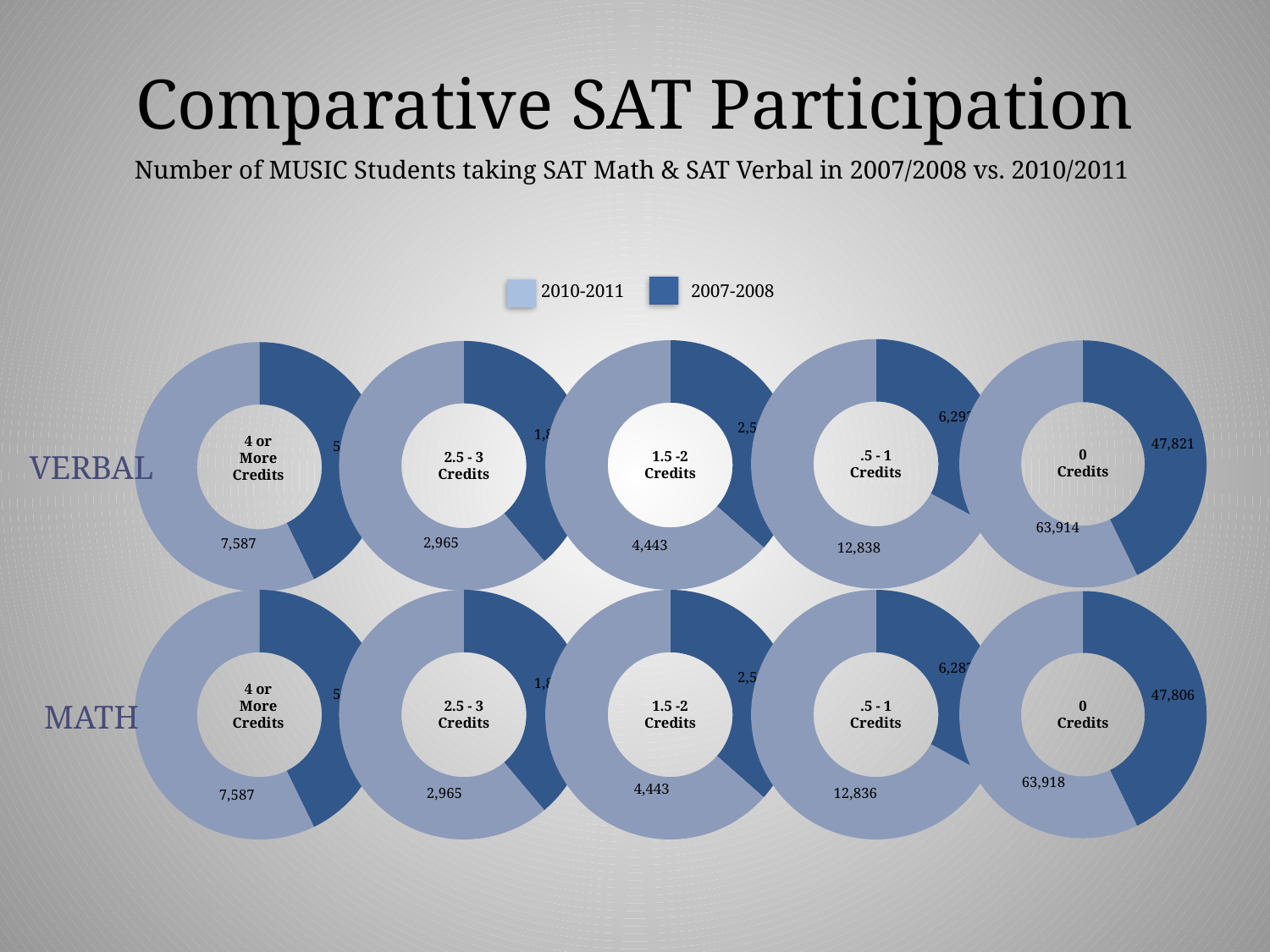
In the VERBAL row '0 Credits' donut chart, what is the difference between the 2010-2011 value and the 2007-2008 value? 16,093 In the MATH row, what is the 2007-2008 value shown on the '0 Credits' donut chart? 47,806 How many donut charts are in the MATH row? 5 How many series does the legend list? 2 In the VERBAL row '0 Credits' donut chart, which series has the larger value, 2010-2011 or 2007-2008? 2010-2011 In the VERBAL row, what is the 2010-2011 value shown on the '4 or More Credits' donut chart? 7,587 In the MATH row '0 Credits' donut chart, what is the difference between the 2010-2011 value and the 2007-2008 value? 16,112 In the VERBAL row, what is the 2010-2011 value shown on the '0 Credits' donut chart? 63,914 In the MATH row, what is the 2010-2011 value shown on the '.5 - 1 Credits' donut chart? 12,836 Among the 2010-2011 values labelled in the VERBAL row, which credit category has the lowest value? 2.5 - 3 Credits What kind of chart is used on this slide? Donut (pie) chart In the VERBAL row, what is the 2007-2008 value shown on the '0 Credits' donut chart? 47,821